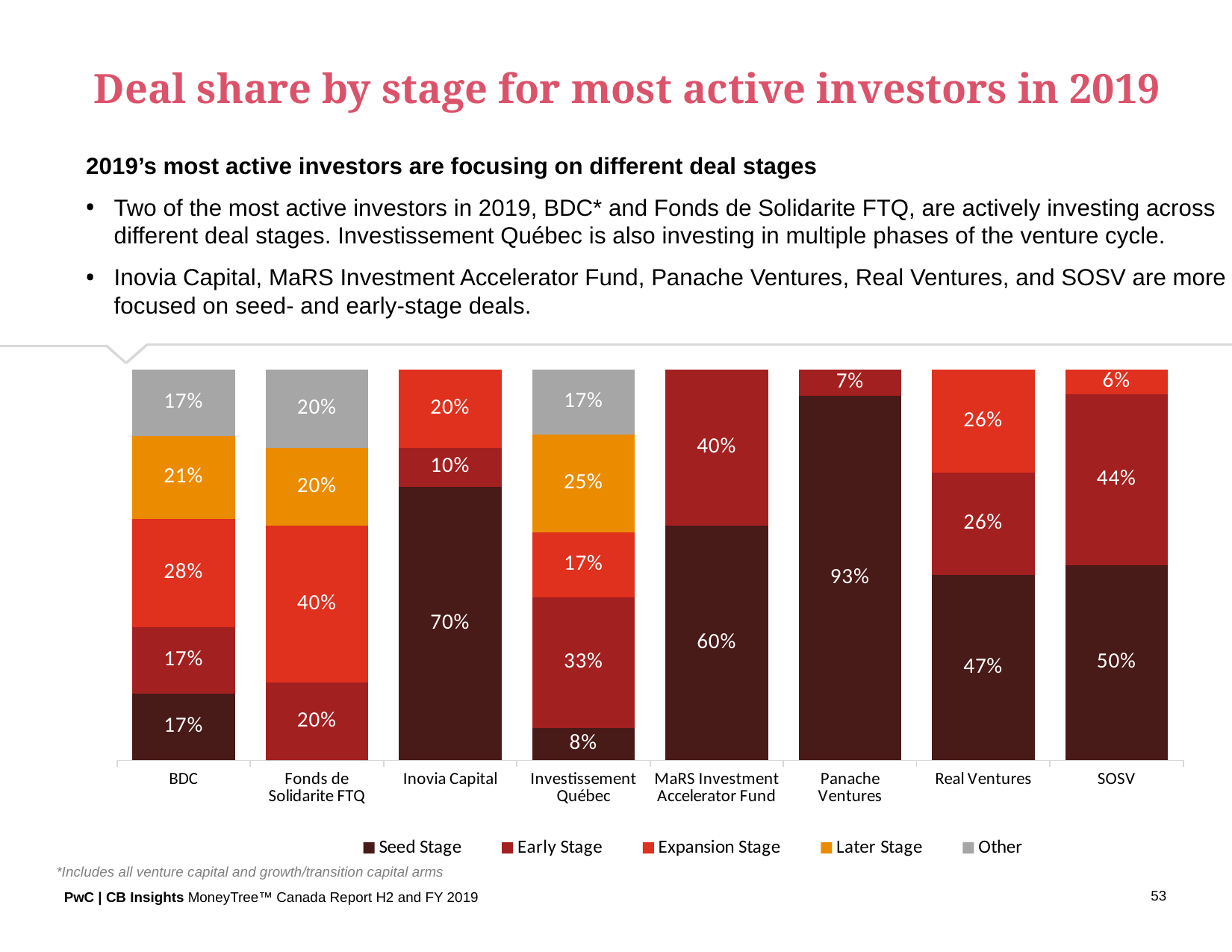
Which is larger: the Early Stage share for Investissement Québec or the Early Stage share for Real Ventures? Investissement Québec What is the Early Stage share for SOSV? 44% How many investors are shown on the x axis of the chart? 8 What is the Later Stage share for Investissement Québec? 25% Which investor has the largest Seed Stage share? Panache Ventures What is the Expansion Stage share for BDC? 28% Which investor has the largest Expansion Stage share? Fonds de Solidarite FTQ How many series does the chart's legend list? 5 What kind of chart is shown on the slide? Stacked bar chart Which colour represents the Later Stage series in the legend? Orange What is the Seed Stage share for Panache Ventures? 93% By how many percentage points does Inovia Capital's Seed Stage share exceed MaRS Investment Accelerator Fund's Seed Stage share? 10 percentage points